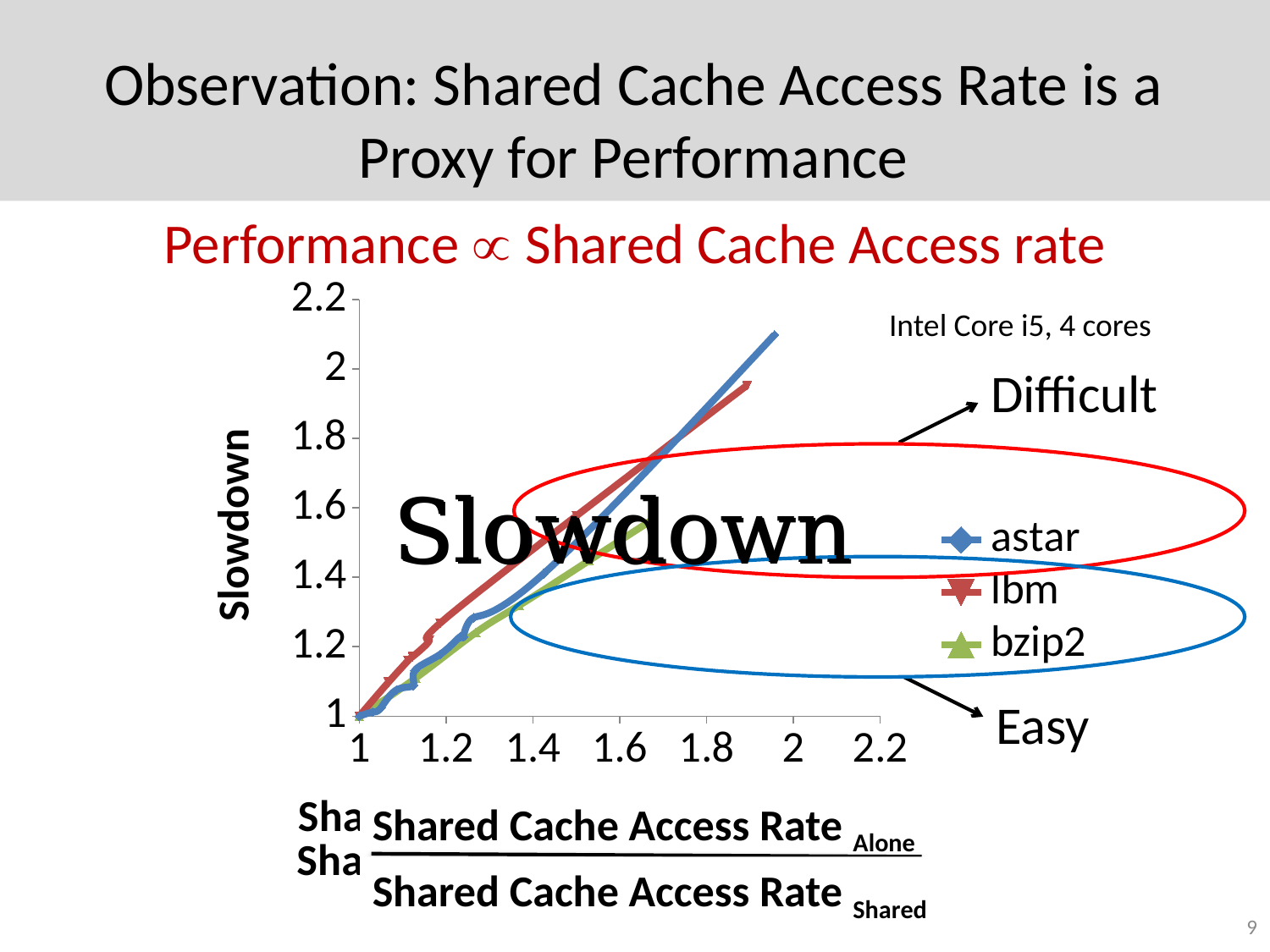
Which series reaches the highest slowdown value on the chart? astar What kind of chart is shown on the slide? line chart Which series reaches the lowest maximum slowdown on the chart? bzip2 What is the highest tick value shown on the vertical axis of the chart? 2.2 Do the slowdown values rise or fall as the x-axis value increases? rise How many series does the chart legend list? 3 Is the highest slowdown reached by the astar series greater or less than 2? greater Is the highest slowdown reached by the bzip2 series greater or less than 1.8? less Is the highest slowdown reached by the lbm series greater or less than 2? less Which series reaches a higher slowdown at the right end of its line, astar or lbm? astar What is the title of the vertical axis of the chart? Slowdown Which series are listed in the chart legend? astar, lbm, bzip2